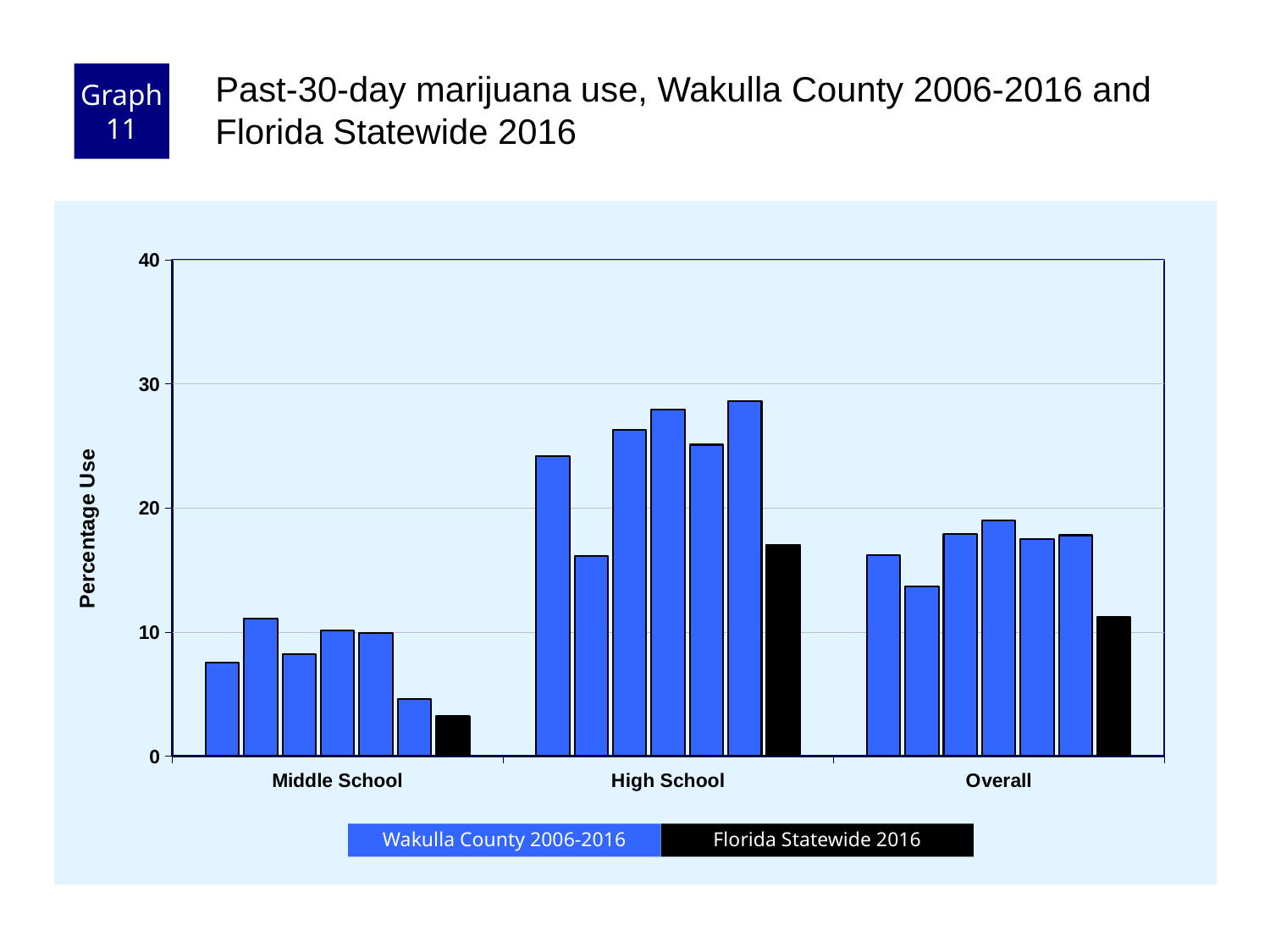
Is the Florida Statewide 2016 value for Middle School greater or less than 10? less Which colour represents Florida Statewide 2016 in the legend? black Which category has the lowest Florida Statewide 2016 value? Middle School Which is larger, the Florida Statewide 2016 value for High School or for Overall? High School Which category has the highest Florida Statewide 2016 value? High School How many series does the legend list? 2 What is the label on the vertical axis? Percentage Use What kind of chart is shown on the slide? bar chart Is the tallest Wakulla County bar in the High School group greater or less than 30? less Is the Florida Statewide 2016 value for High School greater or less than 20? less How many categories are shown on the x axis? 3